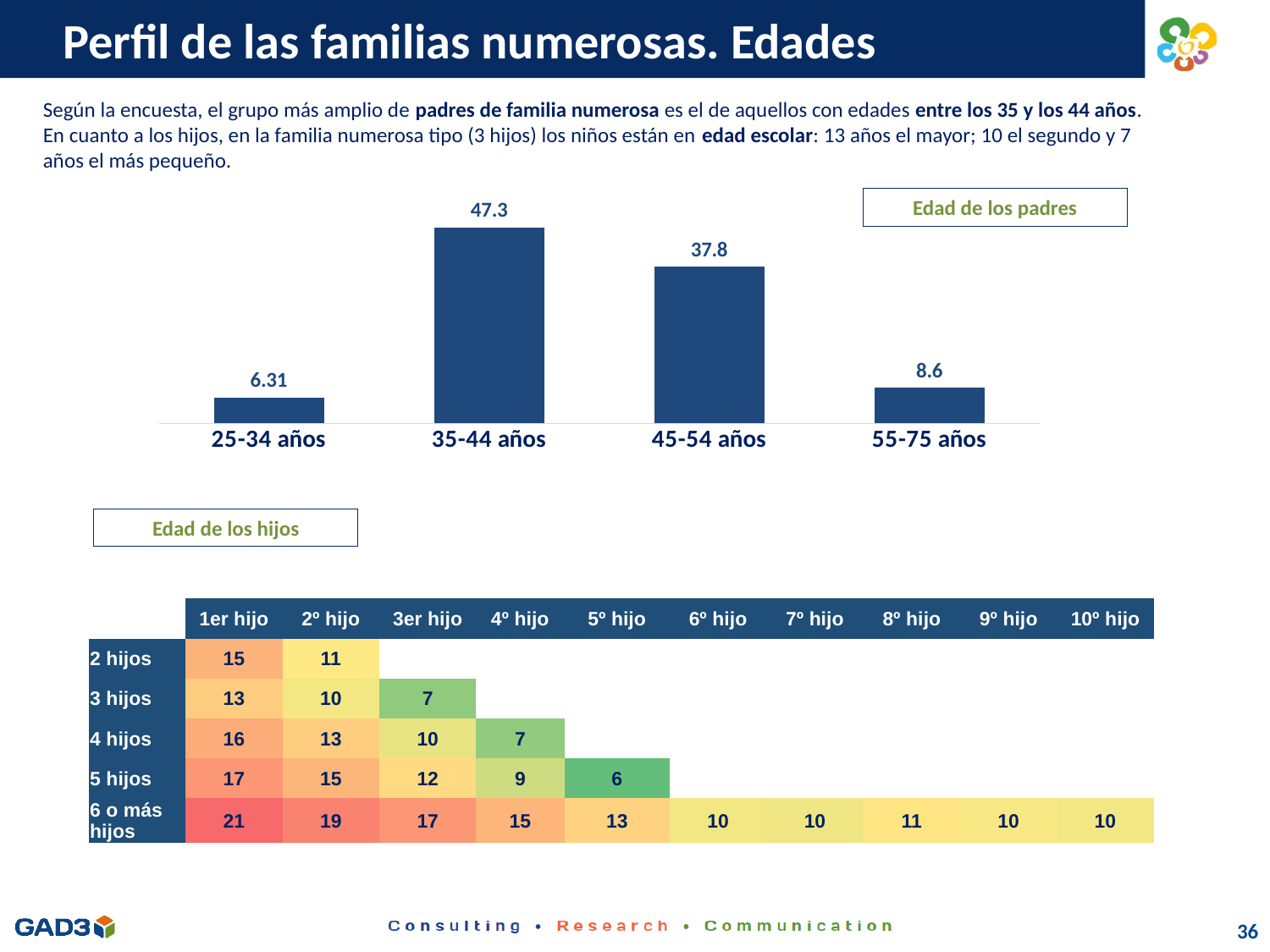
In the 'Edad de los padres' chart, what is the difference between the values for 55-75 años and 25-34 años? 2.29 In the 'Edad de los padres' chart, what is the value for 35-44 años? 47.3 What type of chart is the 'Edad de los padres' chart? Bar chart In the 'Edad de los padres' chart, what is the value for 45-54 años? 37.8 What is the title shown in the box next to the bar chart on the slide? Edad de los padres In the 'Edad de los padres' chart, which age group has the lowest value? 25-34 años In the 'Edad de los padres' chart, what is the value for 55-75 años? 8.6 In the 'Edad de los padres' chart, what is the difference between the values for 35-44 años and 45-54 años? 9.5 In the 'Edad de los padres' chart, which is larger: the value for 45-54 años or for 55-75 años? 45-54 años In the 'Edad de los padres' chart, which age group has the highest value? 35-44 años How many age groups are shown in the 'Edad de los padres' chart? 4 In the 'Edad de los padres' chart, what is the value for 25-34 años? 6.31